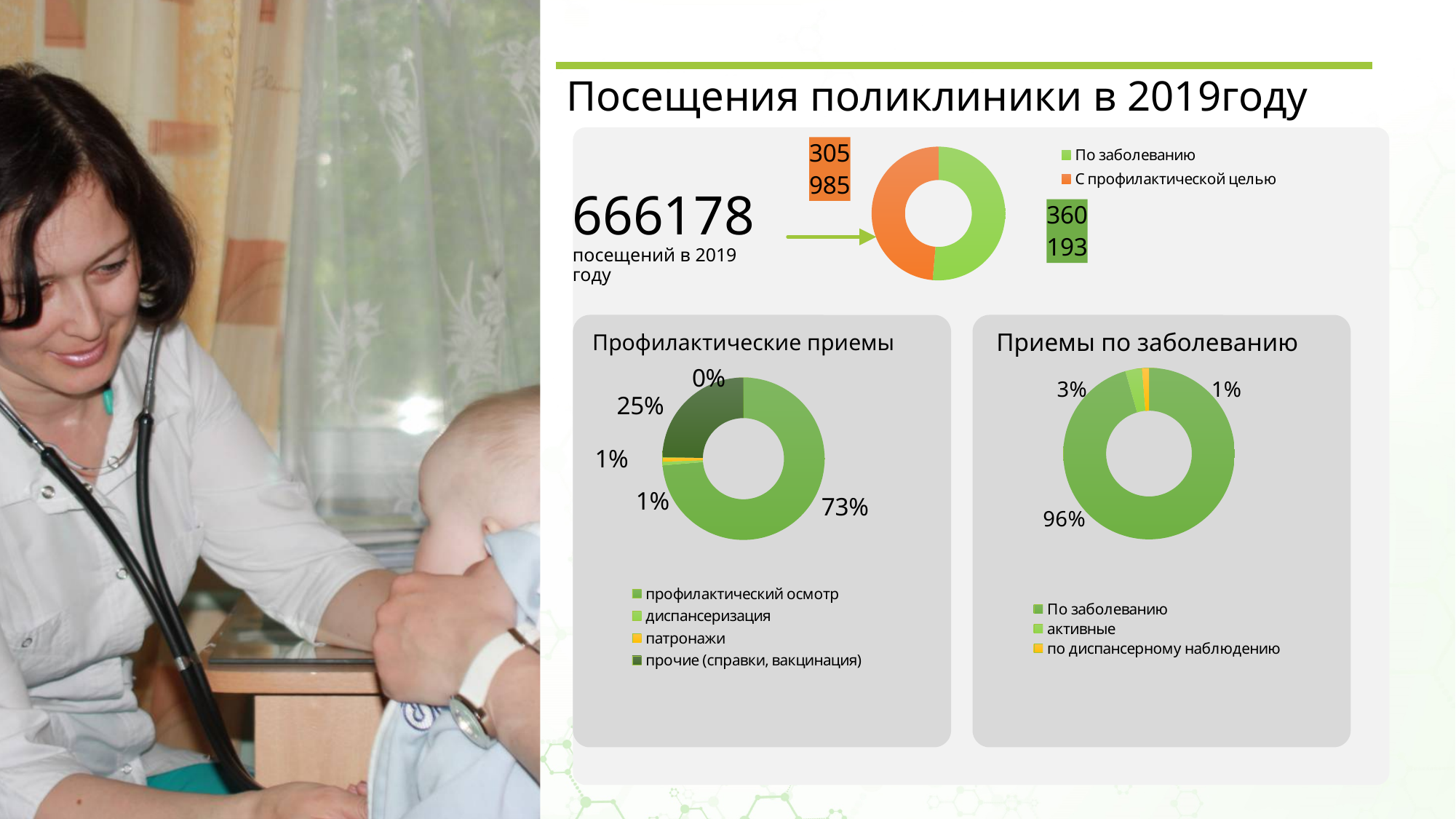
What kind of chart is the Профилактические приемы chart? Pie (donut) chart In the Профилактические приемы chart, what share is прочие (справки, вакцинация)? 25% In the Профилактические приемы chart, what share is профилактический осмотр? 73% In the Приемы по заболеванию chart, which category has the largest share? По заболеванию In the Приемы по заболеванию chart, what share is активные? 3% In the top chart, which is larger: По заболеванию or С профилактической целью? По заболеванию In the top chart, what is the value for По заболеванию? 360 193 In the top chart, what is the total number of visits in 2019 shown on the slide? 666178 In the top chart, what is the difference between По заболеванию and С профилактической целью? 54 208 How many entries does the legend of the top chart list? 2 In the top chart, what is the value for С профилактической целью? 305 985